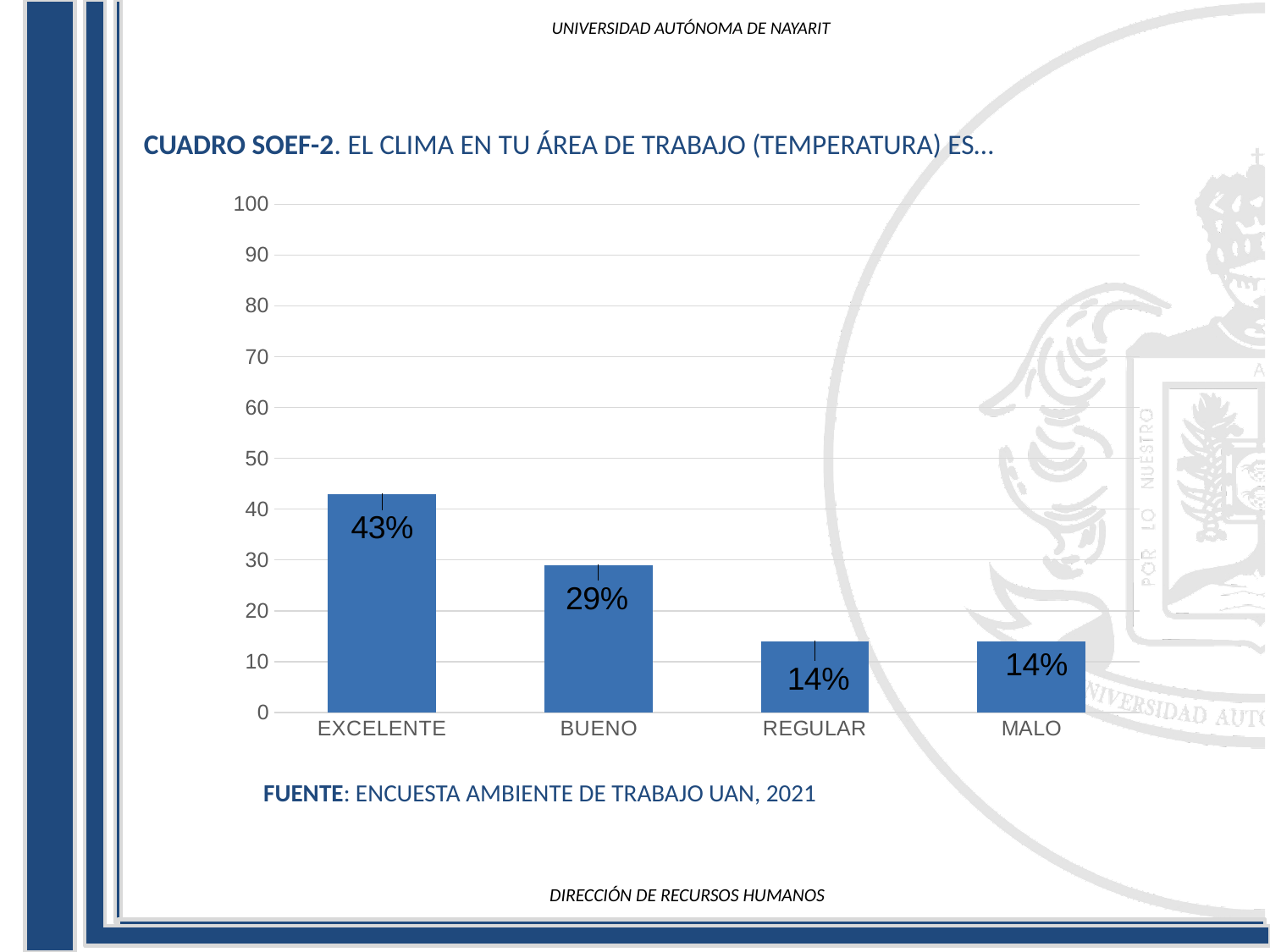
Is the value for EXCELENTE greater or less than 40? greater Do the values rise or fall from EXCELENTE to REGULAR along the x axis? fall What is the value for REGULAR? 14% What kind of chart is shown on the slide? bar chart What is the value for BUENO? 29% Which is larger, the value for BUENO or the value for REGULAR? BUENO What is the difference between the values for EXCELENTE and BUENO? 14% What is the difference between the values for BUENO and MALO? 15% How many categories are shown on the x axis? 4 Which category has the highest value? EXCELENTE What source is cited below the chart? ENCUESTA AMBIENTE DE TRABAJO UAN, 2021 What is the value for EXCELENTE? 43%